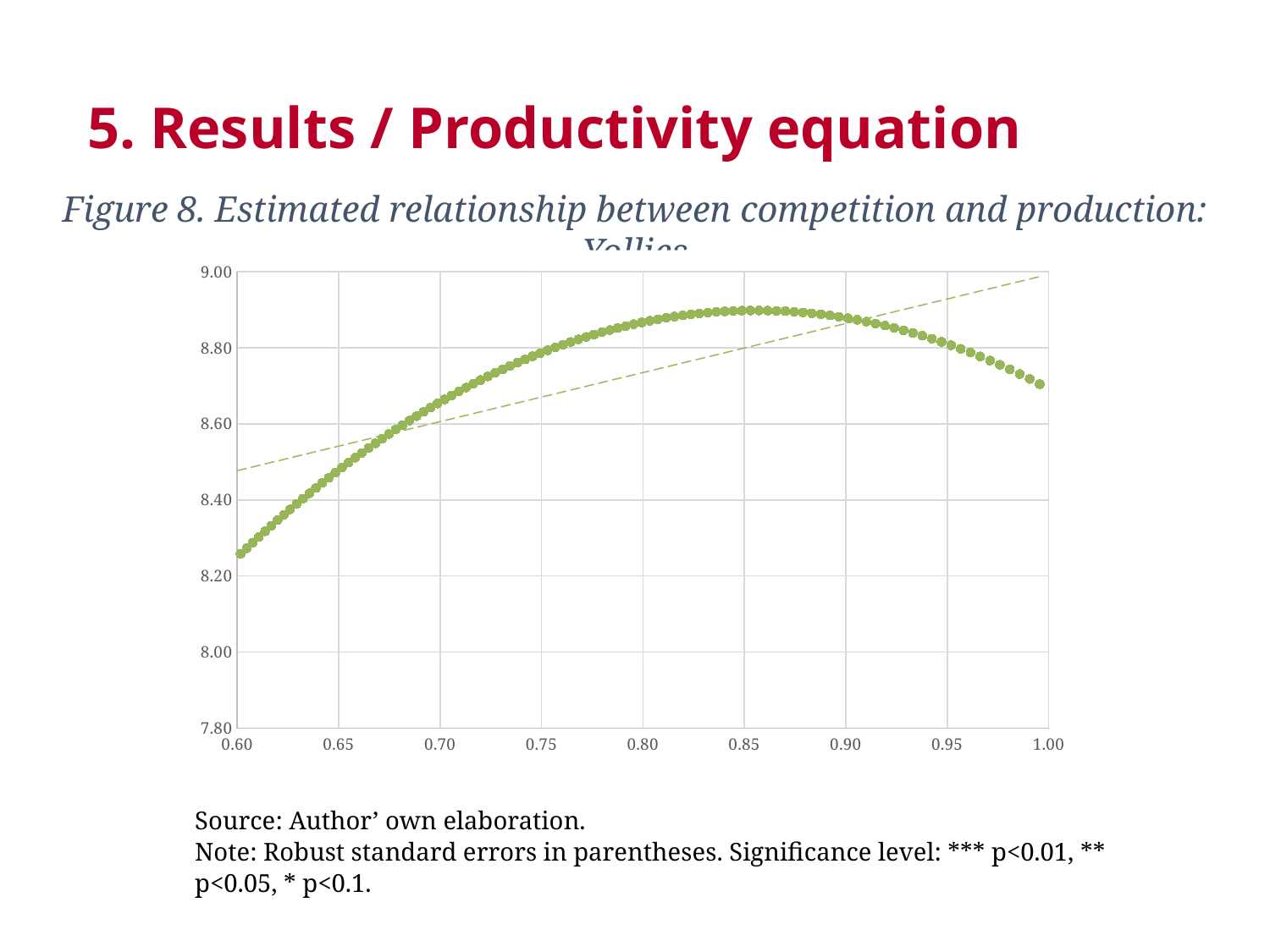
Which has the larger plotted value, x = 0.70 or x = 0.85? 0.85 Do the plotted values rise or fall as the x axis goes from 0.90 to 1.00? fall What is the range of the y axis shown on the chart? 7.80 to 9.00 Is the plotted value at x = 0.90 greater or less than 8.80? greater Is the plotted value at x = 0.70 greater or less than 8.60? greater Which has the larger plotted value, x = 0.60 or x = 0.95? 0.95 Is the plotted value at the right end of the curve (near x = 1.00) greater or less than 8.80? less At which end of the x axis does the curve reach its lowest value? the left end (0.60) What kind of chart is shown on the slide? scatter chart Do the plotted values rise or fall as the x axis goes from 0.60 to about 0.85? rise